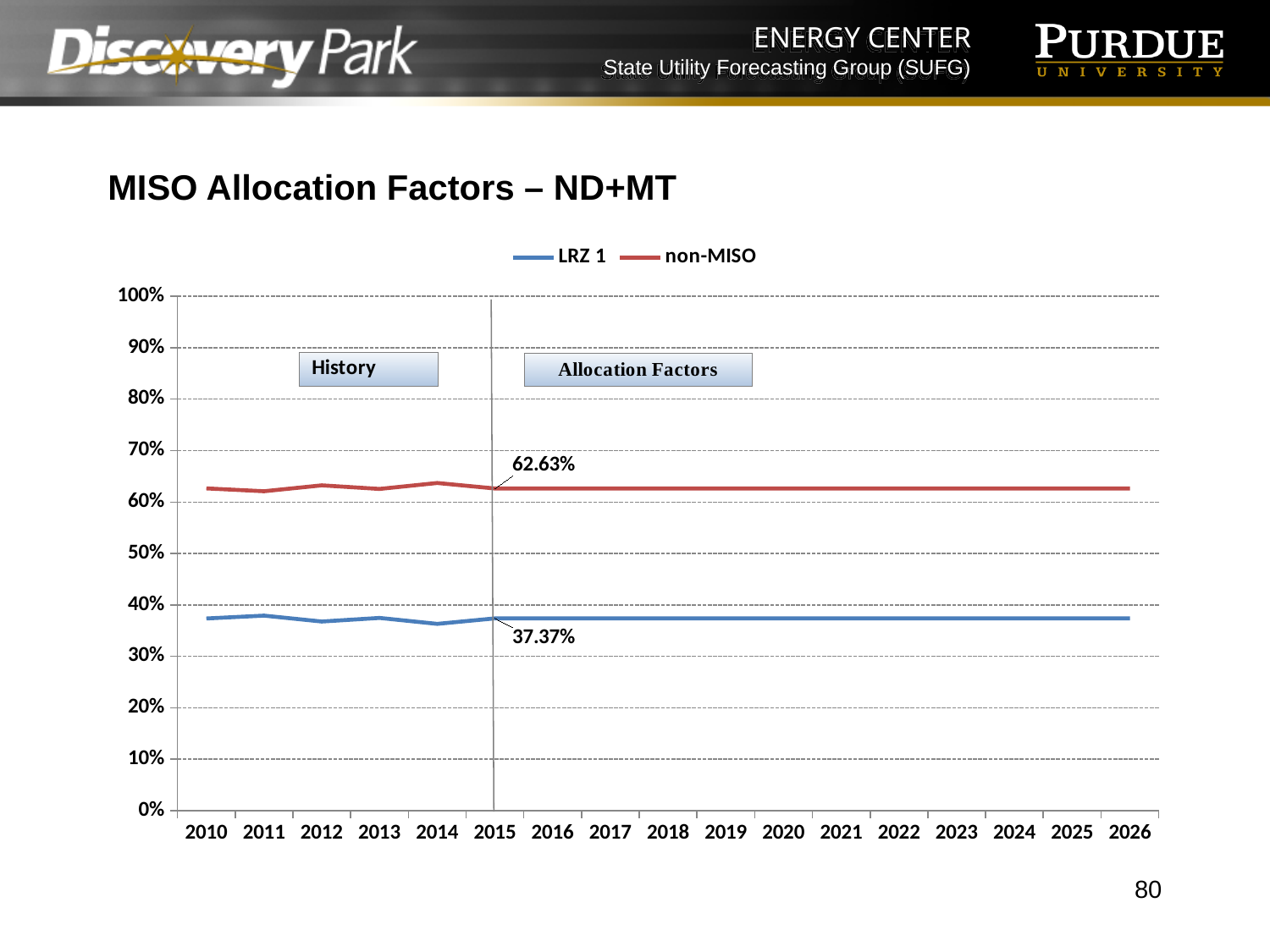
How many years are shown on the x axis of the chart? 17 What is the total of the non-MISO and LRZ 1 values labelled in 2015? 100% How many series does the chart legend list? 2 What is the value labelled for the LRZ 1 series in 2015? 37.37% What type of chart is shown on the slide? line chart What is the difference between the non-MISO and LRZ 1 values labelled in 2015? 25.26% What is the value labelled for the non-MISO series in 2015? 62.63% Is the value for LRZ 1 in 2020 greater or less than 40%? less What are the two series named in the chart legend? LRZ 1 and non-MISO What is the title of the chart on the slide? MISO Allocation Factors – ND+MT Is the value for non-MISO in 2022 greater or less than 60%? greater Which series has the higher values across the chart, LRZ 1 or non-MISO? non-MISO